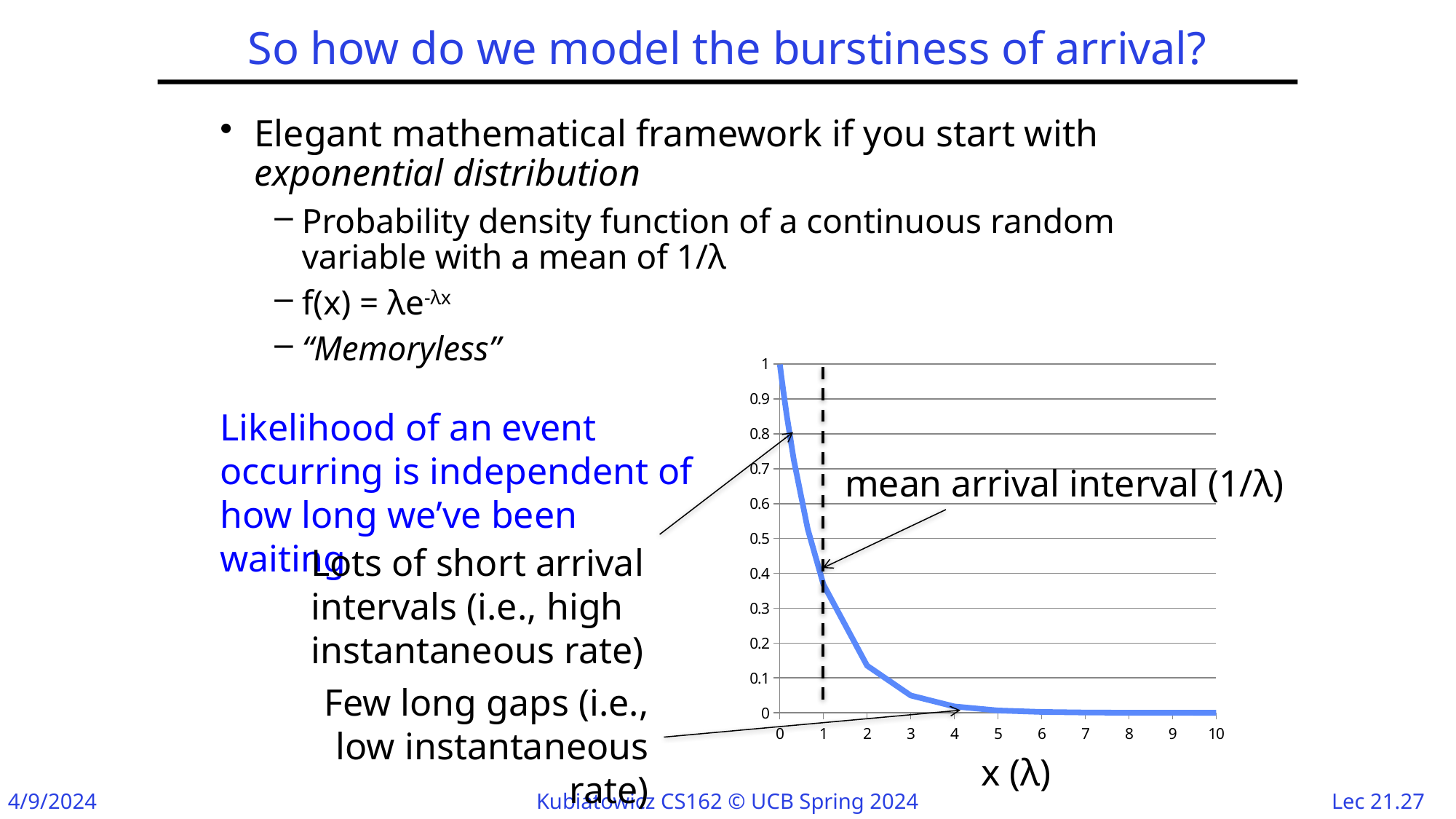
Is the value of the curve at x = 2 greater or less than 0.2? less Is the value of the curve at x = 4 greater or less than 0.1? less At which x value is the dashed vertical line marking the mean arrival interval (1/λ) drawn? 1 Which is larger, the value of the curve at x = 1 or at x = 3? x = 1 Is the value of the curve at x = 1 greater or less than 0.5? less At which x value is the plotted curve highest? 0 What is the label on the x axis of the chart? x (λ) What kind of chart is shown on the slide? line chart What is the highest value shown on the y axis of the chart? 1 Do the plotted values rise or fall as x increases along the x axis? fall